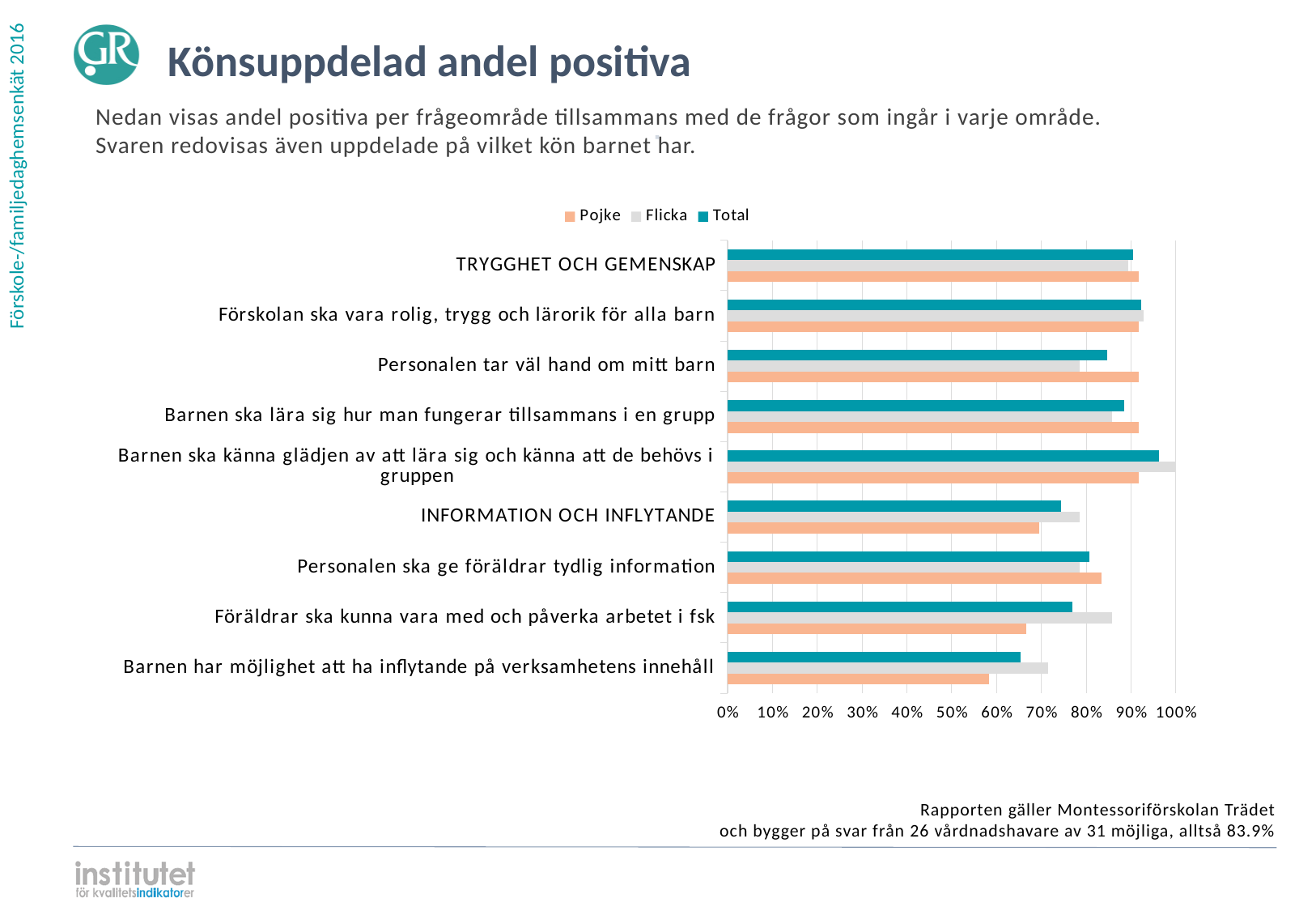
Is the Total value for 'Barnen ska känna glädjen av att lära sig och känna att de behövs i gruppen' greater or less than 90%? greater Is the Pojke value for 'Barnen har möjlighet att ha inflytande på verksamhetens innehåll' greater or less than 70%? less How many categories are shown on the vertical axis of the chart? 9 Which series are listed in the legend? Pojke, Flicka, Total For 'Personalen tar väl hand om mitt barn', which is larger: the Pojke value or the Flicka value? Pojke For 'Föräldrar ska kunna vara med och påverka arbetet i fsk', which is larger: the Pojke value or the Flicka value? Flicka Which category has the lowest Total value? Barnen har möjlighet att ha inflytande på verksamhetens innehåll How many series does the legend list? 3 What is the title of the slide containing the chart? Könsuppdelad andel positiva Is the Flicka value for 'Personalen tar väl hand om mitt barn' greater or less than 90%? less What kind of chart is shown on the slide? Bar chart